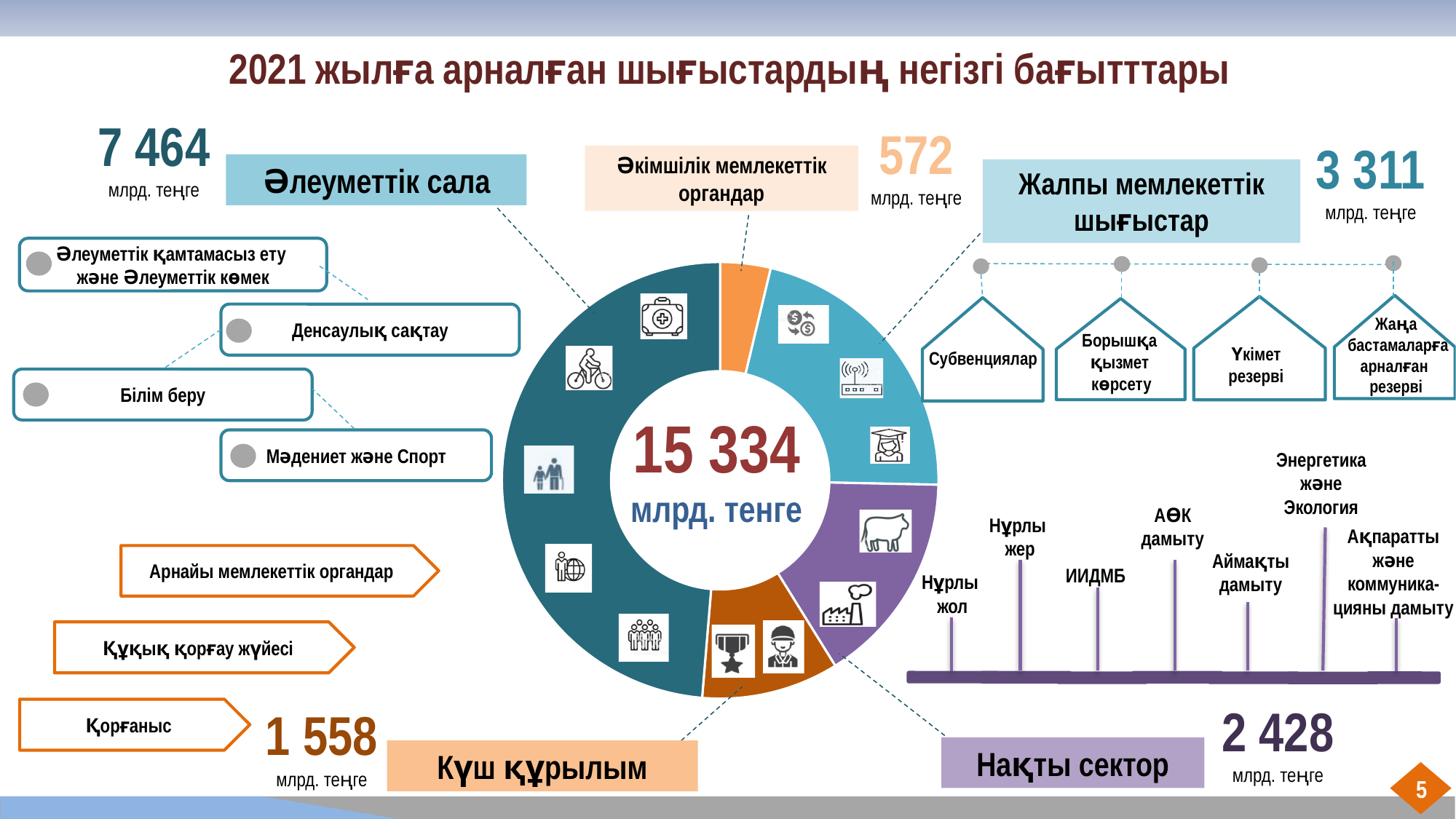
Which category has the smallest value in the donut chart? Әкімшілік мемлекеттік органдар What total value is printed in the centre of the donut chart? 15 334 млрд. тенге What is the difference between the values for Әлеуметтік сала and Жалпы мемлекеттік шығыстар? 4 153 млрд. теңге How many segments does the donut chart have? 5 What is the value shown for Әкімшілік мемлекеттік органдар? 572 млрд. теңге What is the value shown for Жалпы мемлекеттік шығыстар? 3 311 млрд. теңге What is the value shown for Күш құрылым? 1 558 млрд. теңге What type of chart is shown in the centre of the slide? Donut (pie) chart What is the value shown for Нақты сектор? 2 428 млрд. теңге Which category has the largest value in the donut chart? Әлеуметтік сала What is the value shown for Әлеуметтік сала? 7 464 млрд. теңге Which is larger, the value for Нақты сектор or the value for Күш құрылым? Нақты сектор